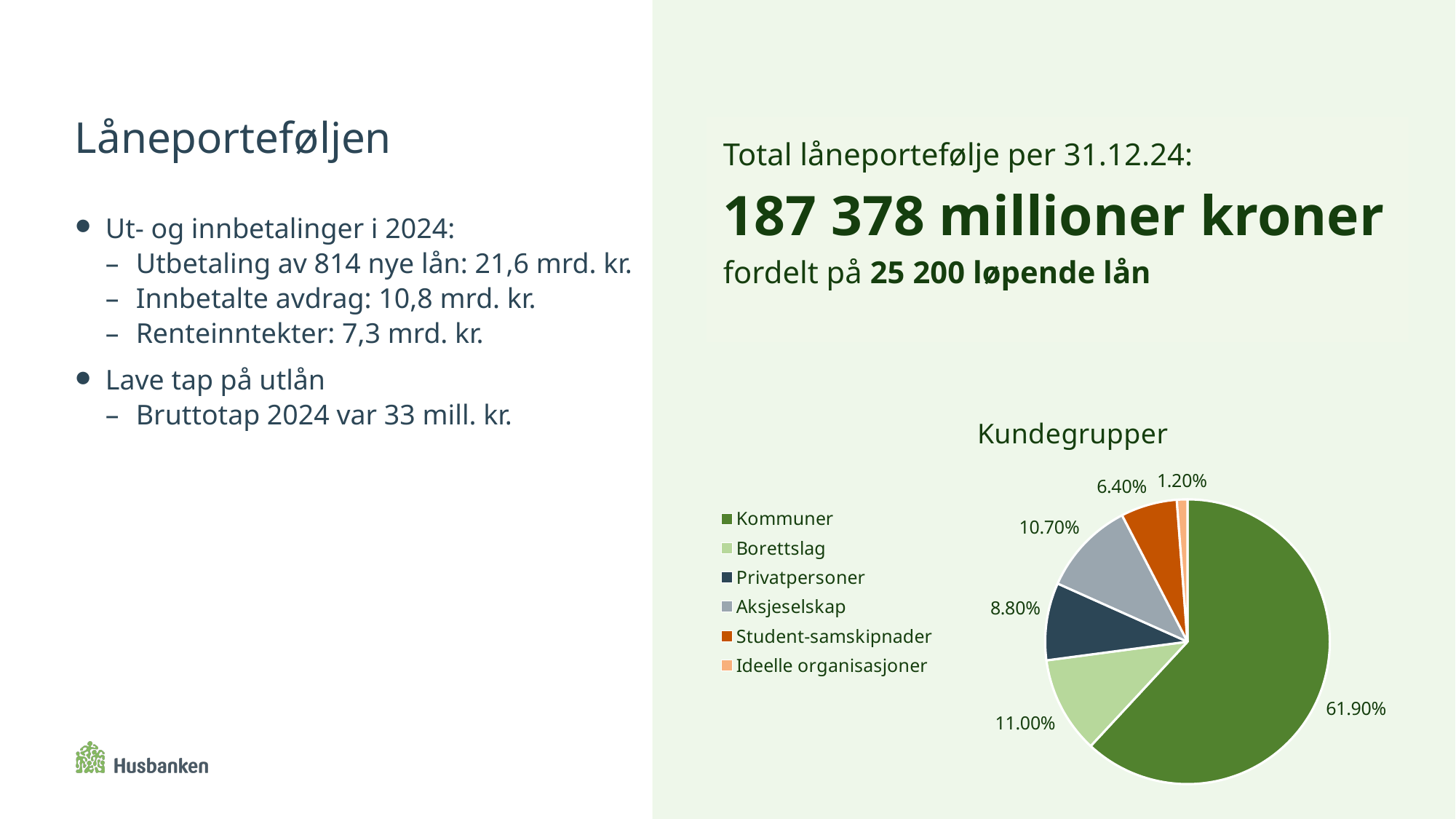
What share of the Kundegrupper pie is Aksjeselskap? 10.70% What share of the Kundegrupper pie is Borettslag? 11.00% What share of the Kundegrupper pie is Student-samskipnader? 6.40% What colour is the Kommuner slice in the Kundegrupper pie? dark green How many customer groups are shown in the Kundegrupper pie chart? 6 What is the difference in percentage points between Kommuner and Borettslag in the Kundegrupper pie? 50.90 What share of the Kundegrupper pie is Kommuner? 61.90% Which is larger in the Kundegrupper pie, Privatpersoner or Aksjeselskap? Aksjeselskap What is the title of the chart on the slide? Kundegrupper What type of chart is the Kundegrupper chart? pie chart Which customer group has the smallest slice in the Kundegrupper pie? Ideelle organisasjoner Which customer group has the largest slice in the Kundegrupper pie? Kommuner